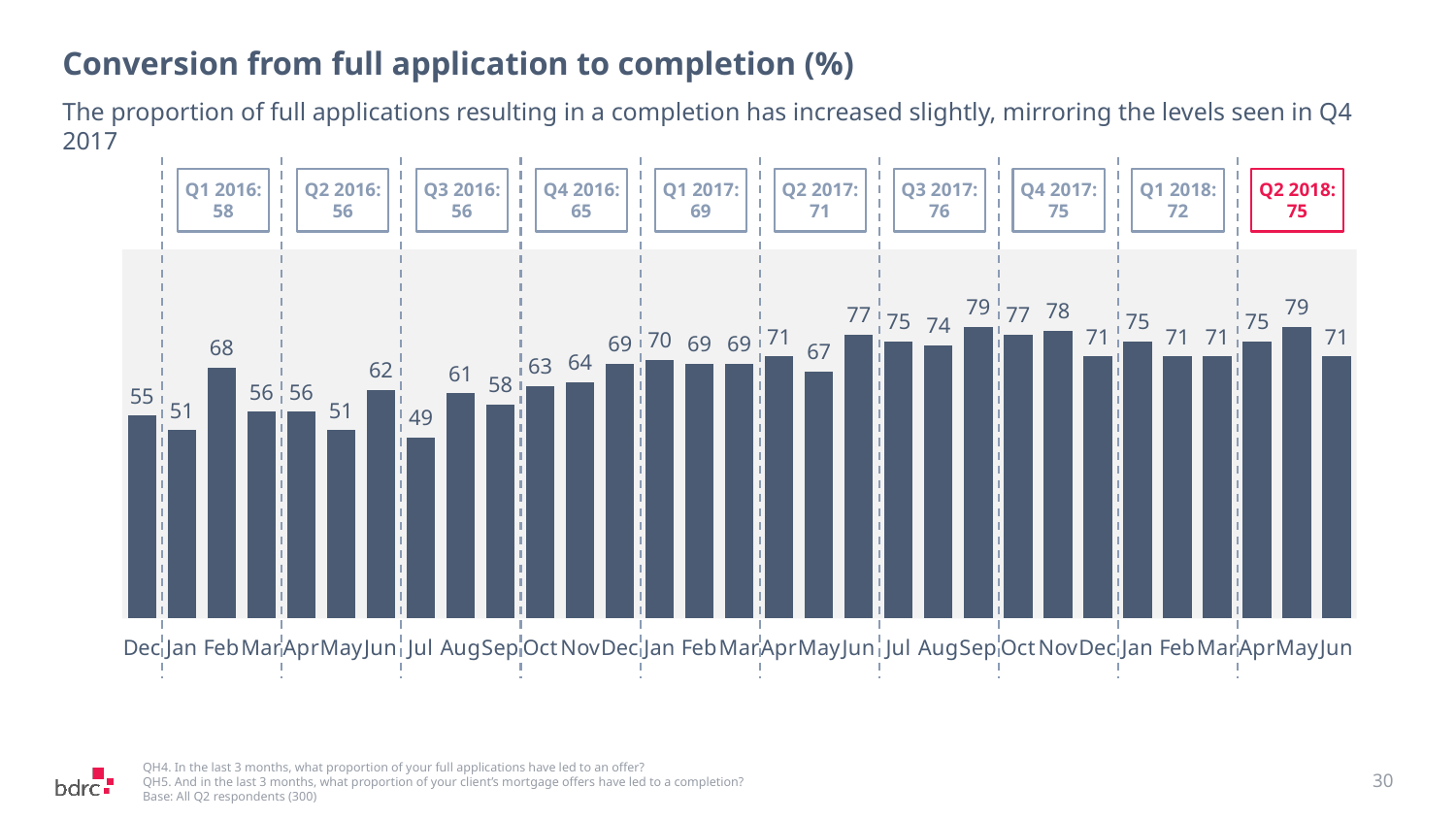
Do the quarterly values rise or fall from Q1 2016 to Q3 2017? rise What is the highest monthly value shown on the chart? 79 What is the quarterly value shown in the box for Q3 2017? 76 What kind of chart is shown on the slide? bar chart Which quarter has the higher quarterly value, Q3 2017 or Q4 2017? Q3 2017 What is the quarterly value shown in the box for Q2 2018? 75 What is the title of the chart? Conversion from full application to completion (%) How many monthly bars are plotted on the chart? 31 What is the value of the Jul bar within the Q3 2016 section? 49 What is the lowest monthly value shown on the chart? 49 What is the value of the Feb bar within the Q1 2016 section? 68 What is the difference between the Q2 2018 quarterly value and the Q1 2018 quarterly value? 3